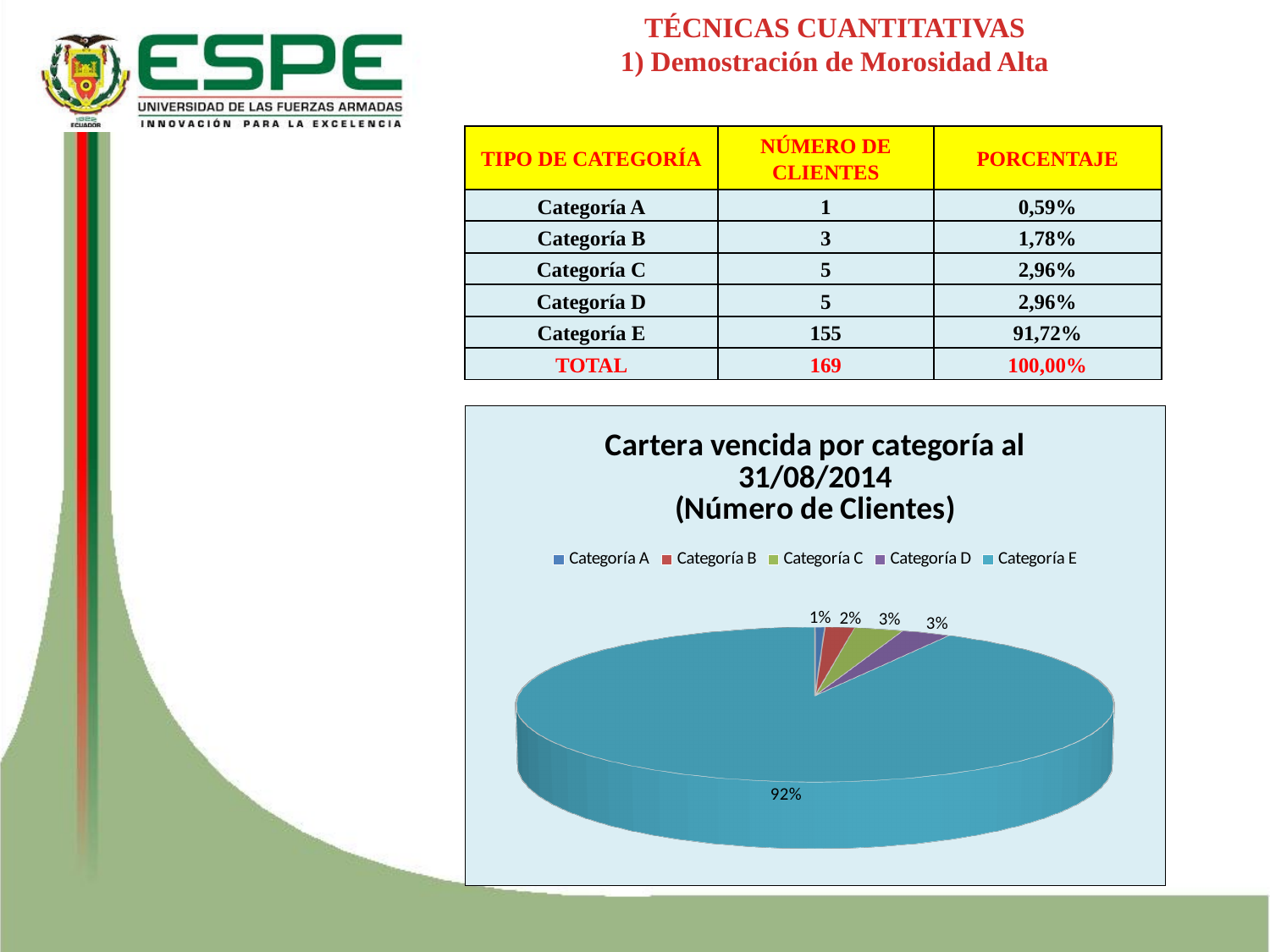
How many categories does the legend of the pie chart list? 5 What is the title of the pie chart? Cartera vencida por categoría al 31/08/2014 (Número de Clientes) What share of the pie chart does Categoría C represent? 3% Which slice is larger in the pie chart, Categoría B or Categoría E? Categoría E Which category has the smallest slice in the pie chart? Categoría A What share of the pie chart does Categoría A represent? 1% Which category has the largest slice in the pie chart? Categoría E What kind of chart is shown on the slide? Pie chart How many slices does the pie chart have? 5 What is the difference in percentage points between the Categoría E slice and the Categoría A slice in the pie chart? 91% What share of the pie chart does Categoría B represent? 2%